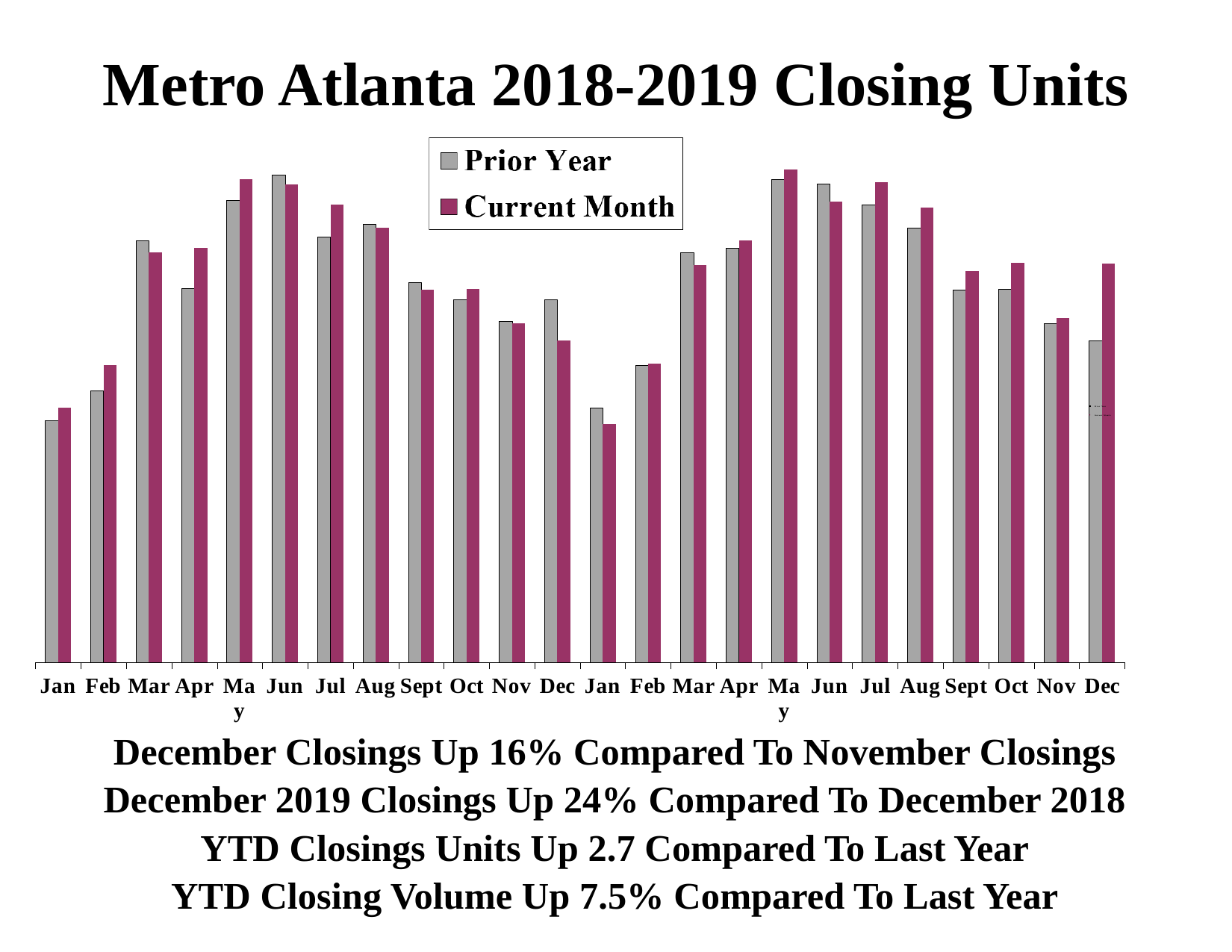
For the second Dec on the x axis, which is larger: Prior Year or Current Month? Current Month How many series does the legend list? 2 Which series is shown in gray in the legend? Prior Year For the first Dec on the x axis, which is larger: Prior Year or Current Month? Prior Year For the second Jan on the x axis, which is larger: Prior Year or Current Month? Prior Year How many month categories are shown along the x axis? 24 What kind of chart is shown on the slide? bar chart What is the title of the chart? Metro Atlanta 2018-2019 Closing Units Which month has the lowest Prior Year value? the first Jan Which month has the lowest Current Month value? the second Jan Do the Prior Year values rise or fall from the first Jan to the first Jun? rise